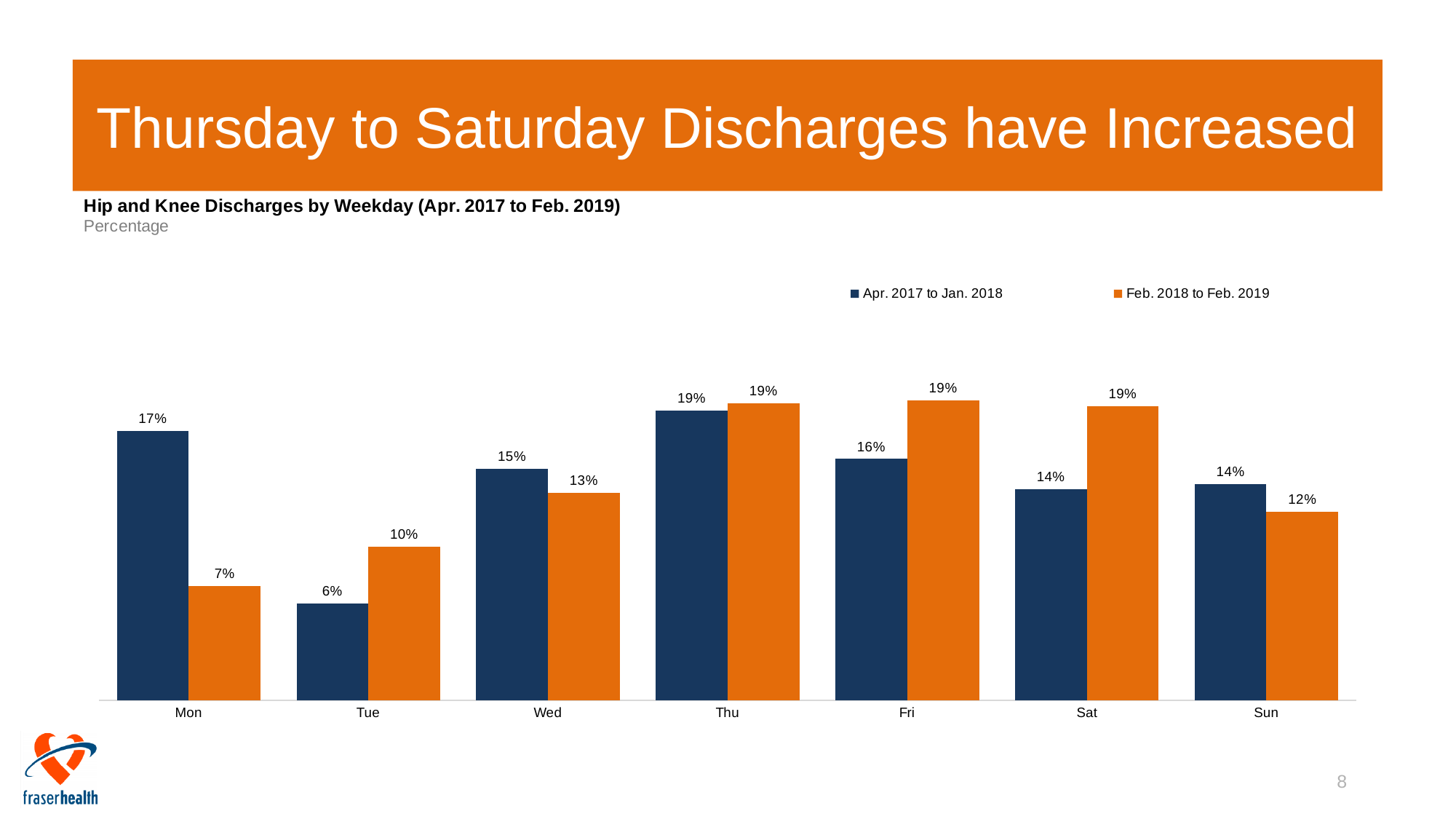
What is the value for Sat in the Feb. 2018 to Feb. 2019 series? 19% How many series does the legend list? 2 How many weekday categories are shown on the x axis? 7 What is the value for Mon in the Apr. 2017 to Jan. 2018 series? 17% What is the value for Tue in the Apr. 2017 to Jan. 2018 series? 6% Which weekday has the lowest value in the Apr. 2017 to Jan. 2018 series? Tue For Wed, which series has the larger value, Apr. 2017 to Jan. 2018 or Feb. 2018 to Feb. 2019? Apr. 2017 to Jan. 2018 What is the difference between the Feb. 2018 to Feb. 2019 and Apr. 2017 to Jan. 2018 values for Sat? 5% What is the difference between the Apr. 2017 to Jan. 2018 and Feb. 2018 to Feb. 2019 values for Mon? 10% For Tue, which series has the larger value, Apr. 2017 to Jan. 2018 or Feb. 2018 to Feb. 2019? Feb. 2018 to Feb. 2019 What kind of chart is shown on the slide? Bar chart Which weekday has the lowest value in the Feb. 2018 to Feb. 2019 series? Mon